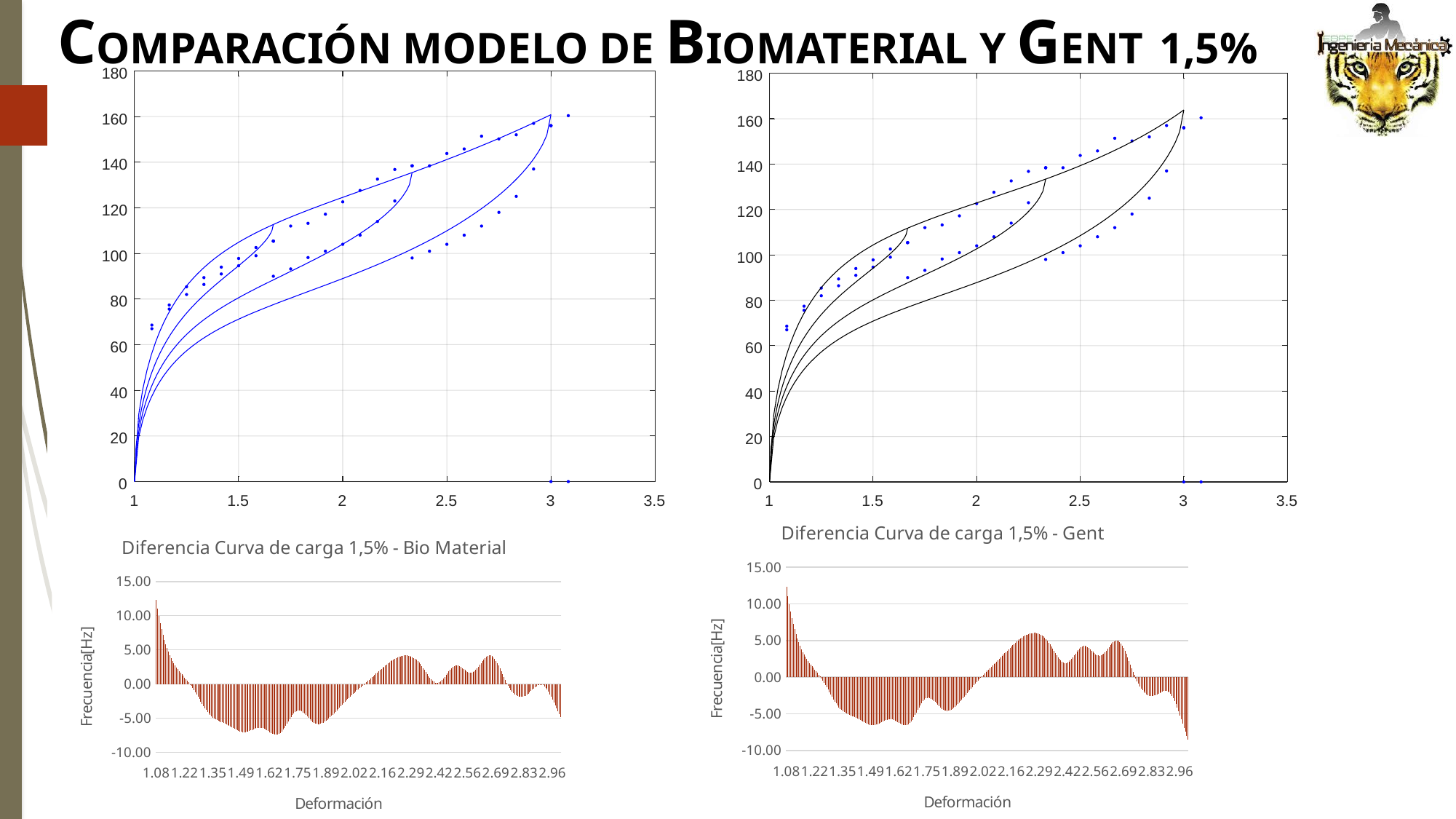
In the bottom-left chart 'Diferencia Curva de carga 1,5% - Bio Material', is the lowest bar near 1.62 greater or less than -5.00? less In the bottom-left chart 'Diferencia Curva de carga 1,5% - Bio Material', at which x-axis value is the highest bar? 1.08 What is the y-axis label of the bottom-left chart 'Diferencia Curva de carga 1,5% - Bio Material'? Frecuencia[Hz] What kind of chart is the bottom-left chart titled 'Diferencia Curva de carga 1,5% - Bio Material'? bar chart In the bottom-right chart 'Diferencia Curva de carga 1,5% - Gent', is the value of the first bar at 1.08 greater or less than 10.00? greater In the top-right chart, is the peak of the black curve near x = 3 greater or less than 140? greater What is the title of the bottom-right chart? Diferencia Curva de carga 1,5% - Gent In the bottom-right chart 'Diferencia Curva de carga 1,5% - Gent', at which x-axis value is the highest bar? 1.08 In the bottom-left chart 'Diferencia Curva de carga 1,5% - Bio Material', do the bars rise or fall from 1.08 to 1.22? fall